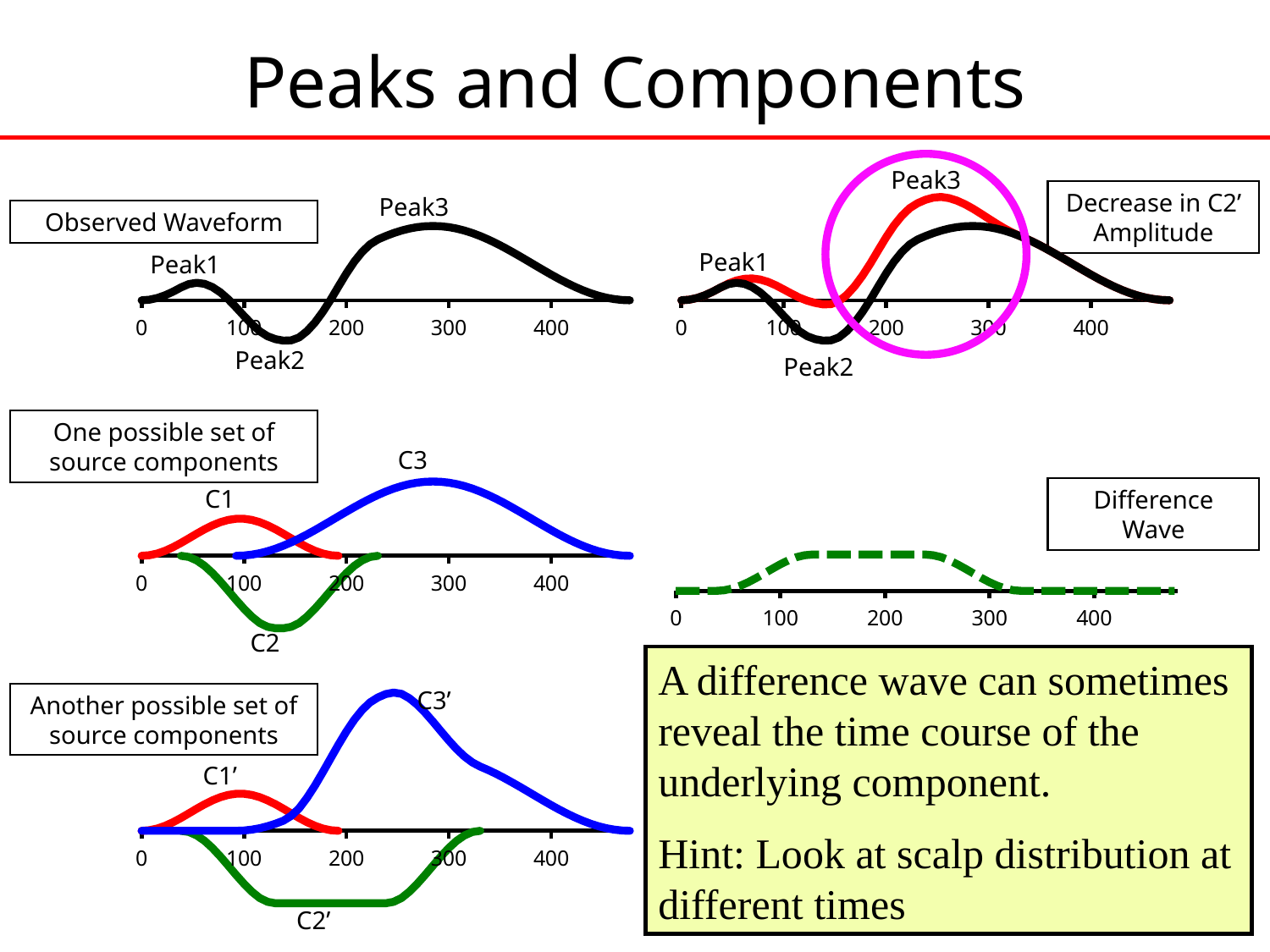
What colour is the C2 component in the 'One possible set of source components' chart? green In the 'One possible set of source components' chart, which component is negative-going? C2 In the Observed Waveform chart, how many peaks are labelled? 3 In the Observed Waveform chart, which labelled peak has the largest positive amplitude? Peak3 What kind of chart is the Observed Waveform chart? line chart In the Observed Waveform chart, which labelled peak is negative-going (below the axis)? Peak2 In the 'One possible set of source components' chart, which component has the larger peak amplitude, C1 or C3? C3 In the top-right chart, which peak is enclosed by the magenta circle? Peak3 In the Observed Waveform chart, is Peak1 located at an x value greater or less than 100? less In the Observed Waveform chart, is Peak3 located at an x value greater or less than 200? greater In the 'One possible set of source components' chart, how many components are plotted? 3 In the 'Another possible set of source components' chart, is the peak of C3' located at an x value greater or less than 200? greater